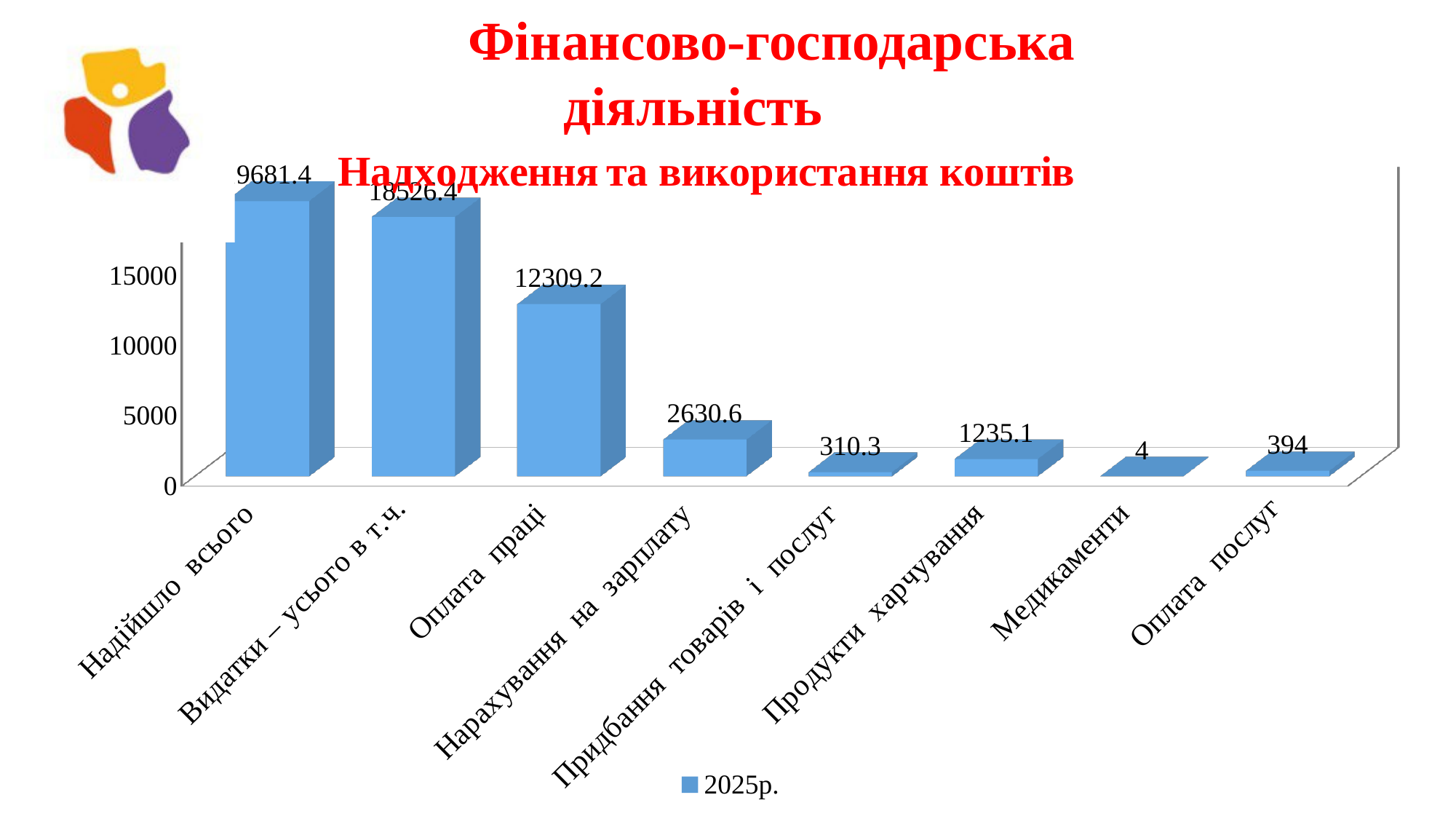
What is the value for Видатки – усього в т.ч.? 18526.4 What is the value for Нарахування на зарплату? 2630.6 What is the value for Оплата послуг? 394 What is the value for Медикаменти? 4 What is the difference between the values for Оплата праці and Нарахування на зарплату? 9678.6 Which is larger, the value for Продукти харчування or the value for Оплата послуг? Продукти харчування Which category has the lowest value? Медикаменти How many categories are shown on the x axis? 8 What is the difference between the values for Продукти харчування and Придбання товарів і послуг? 924.8 Is the value for Оплата праці greater or less than 10000? greater How many series does the legend list, and what is it called? 1, 2025р. What is the value for Оплата праці? 12309.2